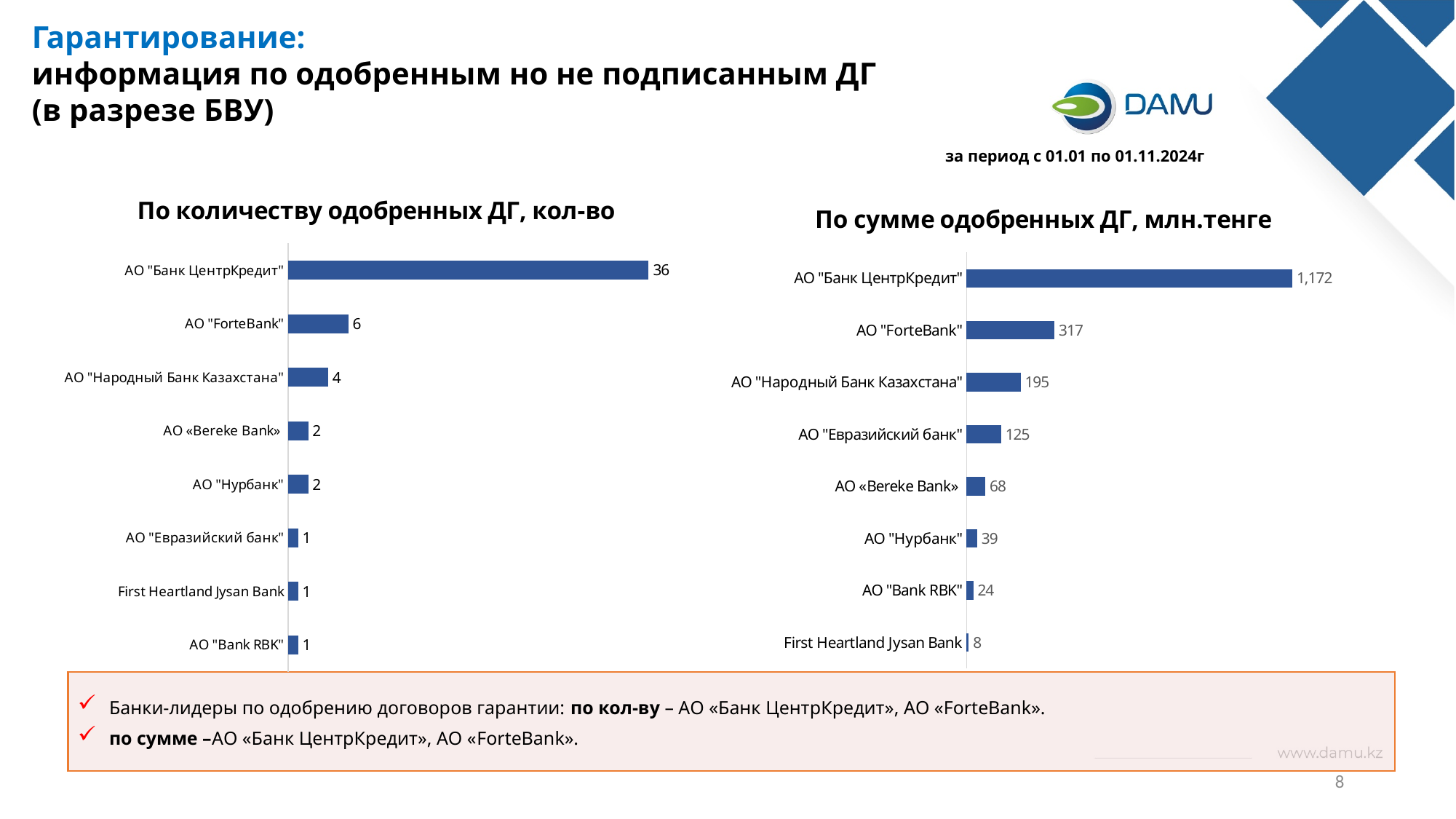
What is the title of the chart on the right side of the slide? По сумме одобренных ДГ, млн.тенге What type of chart is "По сумме одобренных ДГ, млн.тенге"? Bar chart In the chart "По количеству одобренных ДГ, кол-во", what is the value for АО "Банк ЦентрКредит"? 36 In the chart "По сумме одобренных ДГ, млн.тенге", which bank has the lowest value? First Heartland Jysan Bank In the chart "По количеству одобренных ДГ, кол-во", what is the value for АО "Народный Банк Казахстана"? 4 In the chart "По сумме одобренных ДГ, млн.тенге", what is the difference between АО "Народный Банк Казахстана" and АО "Евразийский банк"? 70 How many banks are shown in the chart "По количеству одобренных ДГ, кол-во"? 8 In the chart "По сумме одобренных ДГ, млн.тенге", what is the value for АО "ForteBank"? 317 In the chart "По количеству одобренных ДГ, кол-во", what is the difference between АО "Банк ЦентрКредит" and АО "ForteBank"? 30 How many banks are shown in the chart "По сумме одобренных ДГ, млн.тенге"? 8 In the chart "По сумме одобренных ДГ, млн.тенге", which is larger: АО «Bereke Bank» or АО "Нурбанк"? АО «Bereke Bank» In the chart "По сумме одобренных ДГ, млн.тенге", which bank has the highest value? АО "Банк ЦентрКредит"